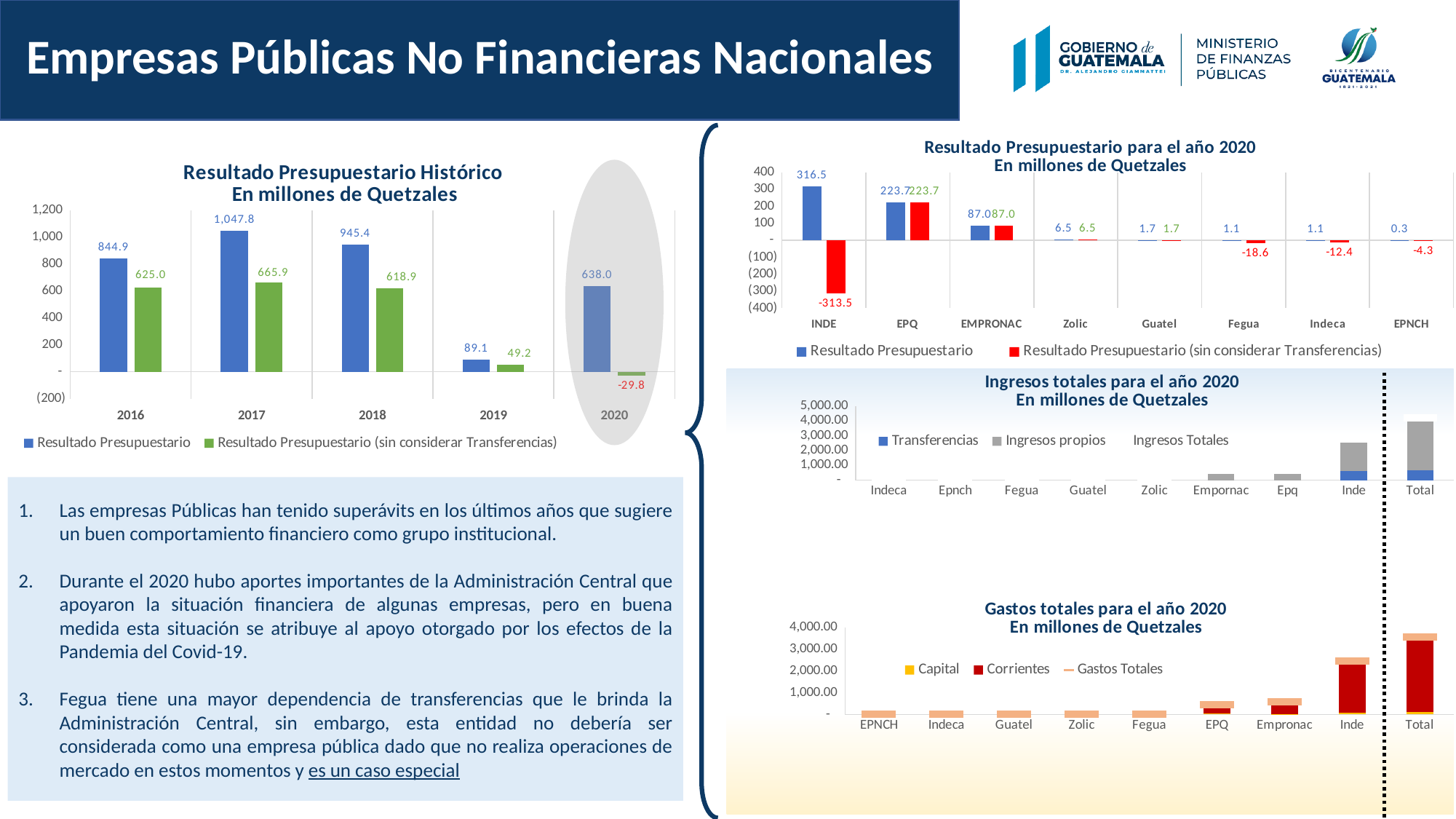
In the 'Resultado Presupuestario para el año 2020' chart, what is the Resultado Presupuestario (sin considerar Transferencias) for INDE? -313.5 In the 'Resultado Presupuestario Histórico' chart, what is the value of Resultado Presupuestario for 2017? 1,047.8 In the 'Gastos totales para el año 2020' chart, is the value for Inde greater or less than 1,000.00? greater In the 'Resultado Presupuestario Histórico' chart, what is the value of Resultado Presupuestario (sin considerar Transferencias) for 2020? -29.8 In the 'Resultado Presupuestario Histórico' chart, how many years are shown on the x axis? 5 In the 'Ingresos totales para el año 2020' chart, how many series does the legend list? 3 In the 'Resultado Presupuestario para el año 2020' chart, is the Resultado Presupuestario for EPQ larger or smaller than that for EMPRONAC? larger In the 'Resultado Presupuestario Histórico' chart, what is the difference between Resultado Presupuestario and Resultado Presupuestario (sin considerar Transferencias) in 2016? 219.9 In the 'Resultado Presupuestario para el año 2020' chart, which entity has the lowest Resultado Presupuestario (sin considerar Transferencias)? INDE In the 'Resultado Presupuestario Histórico' chart, which year has the lowest Resultado Presupuestario? 2019 In the 'Resultado Presupuestario para el año 2020' chart, what is the Resultado Presupuestario for EMPRONAC? 87.0 In the 'Resultado Presupuestario Histórico' chart, which year has the highest Resultado Presupuestario? 2017